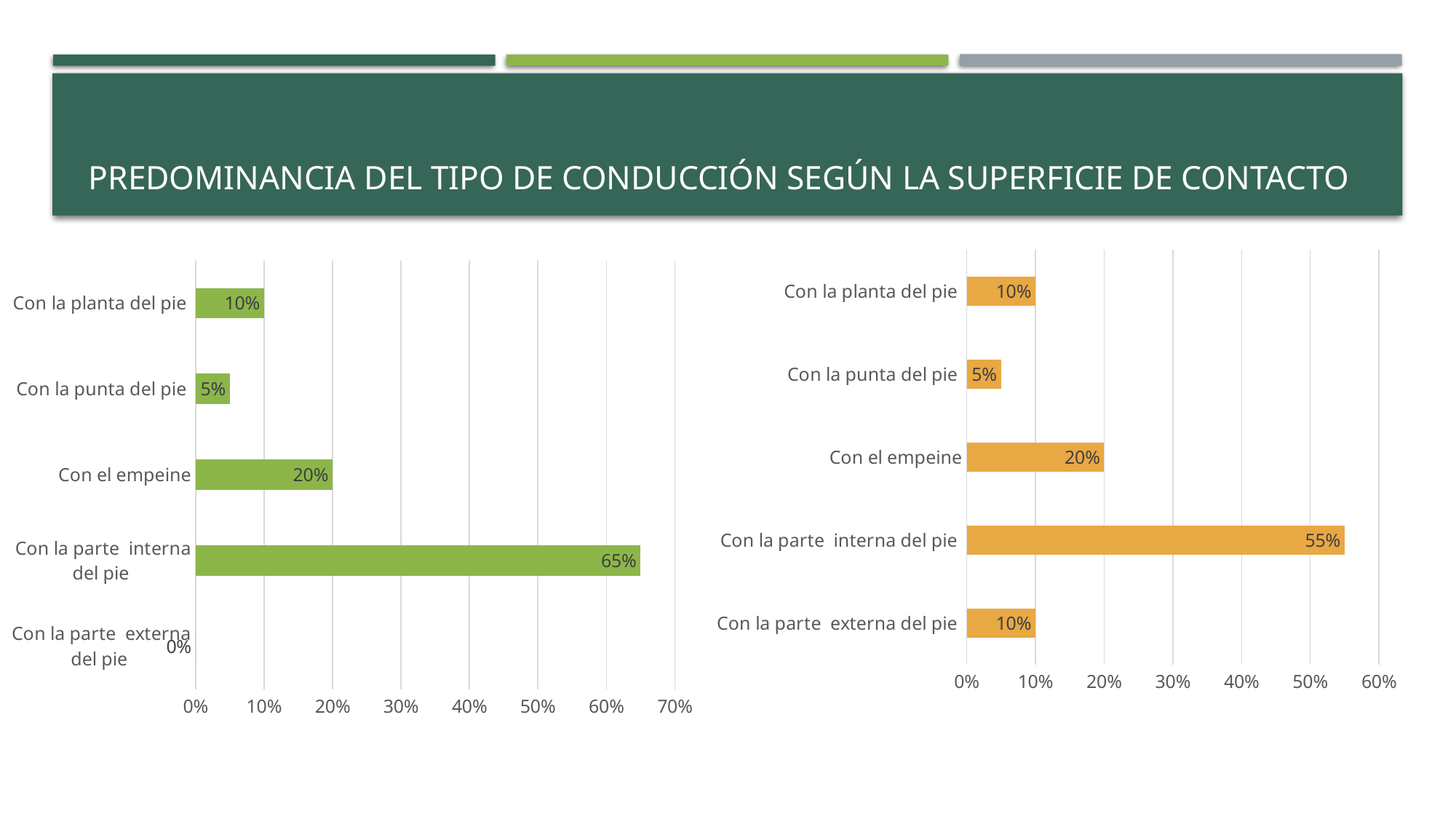
In the left chart, what is the difference between Con la parte interna del pie and Con el empeine? 45% In the left chart, what is the value for Con la parte externa del pie? 0% In the right chart, what is the value for Con la parte externa del pie? 10% In the left chart, which category has the highest value? Con la parte interna del pie How many categories does the left chart show? 5 In the right chart, which category has the lowest value? Con la punta del pie In the right chart, what is the difference between Con la parte interna del pie and Con la planta del pie? 45% What is the title shown on the slide? PREDOMINANCIA DEL TIPO DE CONDUCCIÓN SEGÚN LA SUPERFICIE DE CONTACTO What kind of chart is the right chart? Bar chart In the left chart, what is the value for Con la parte interna del pie? 65% In the right chart, which is larger: Con el empeine or Con la punta del pie? Con el empeine In the right chart, what is the value for Con la parte interna del pie? 55%